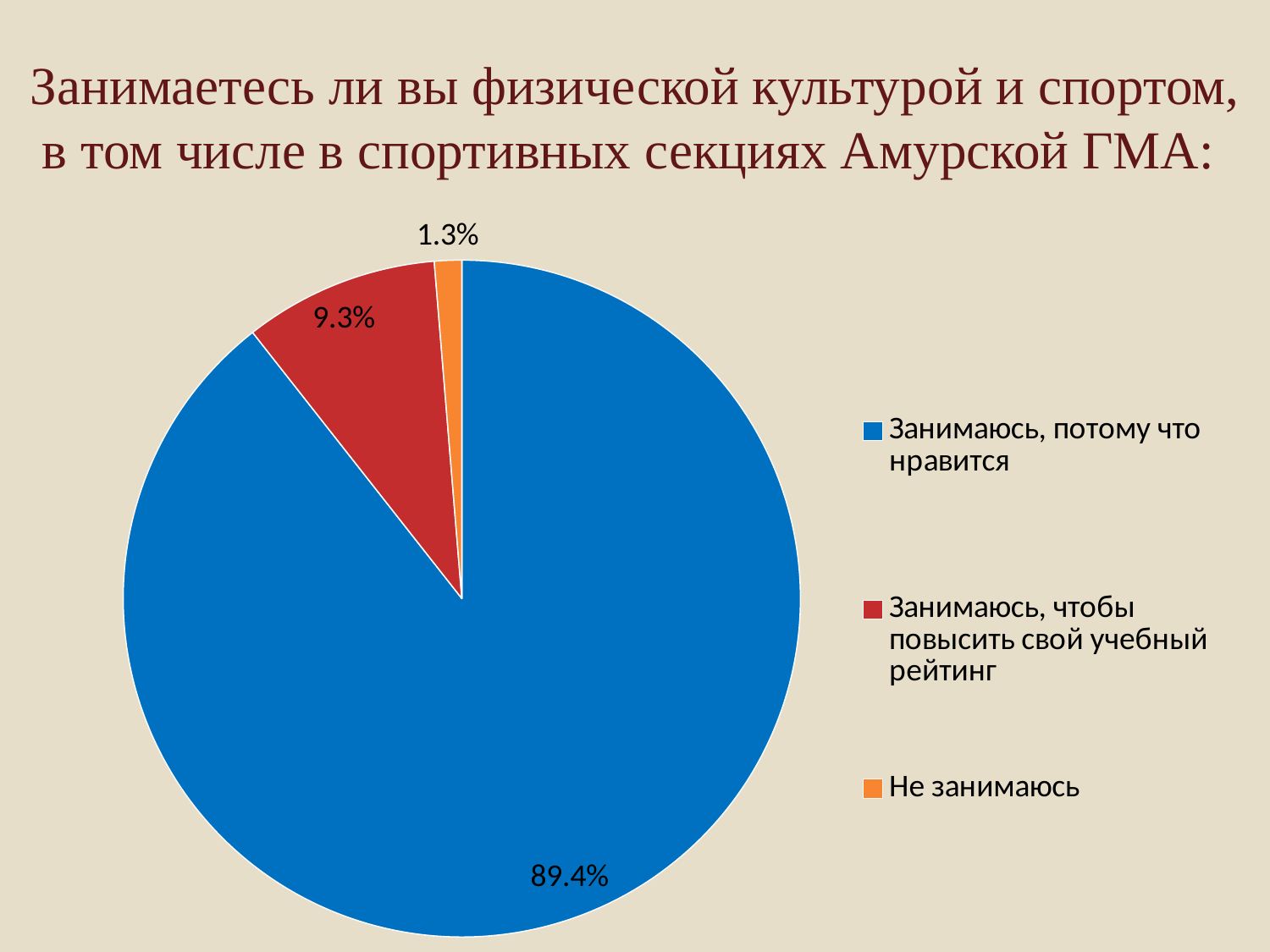
What share of the pie is labelled "Занимаюсь, чтобы повысить свой учебный рейтинг"? 9.3% Which category has the smallest slice of the pie? Не занимаюсь How many entries does the legend list? 3 What is the difference between the share for "Занимаюсь, чтобы повысить свой учебный рейтинг" and the share for "Не занимаюсь"? 8.0% What is the difference between the share for "Занимаюсь, потому что нравится" and the share for "Занимаюсь, чтобы повысить свой учебный рейтинг"? 80.1% What colour is the slice for "Не занимаюсь"? orange Which category has the largest slice of the pie? Занимаюсь, потому что нравится What kind of chart is shown on the slide? pie chart Which is larger: the share for "Занимаюсь, чтобы повысить свой учебный рейтинг" or the share for "Не занимаюсь"? Занимаюсь, чтобы повысить свой учебный рейтинг What share of the pie is labelled "Занимаюсь, потому что нравится"? 89.4% How many categories does the pie chart show? 3 What share of the pie is labelled "Не занимаюсь"? 1.3%